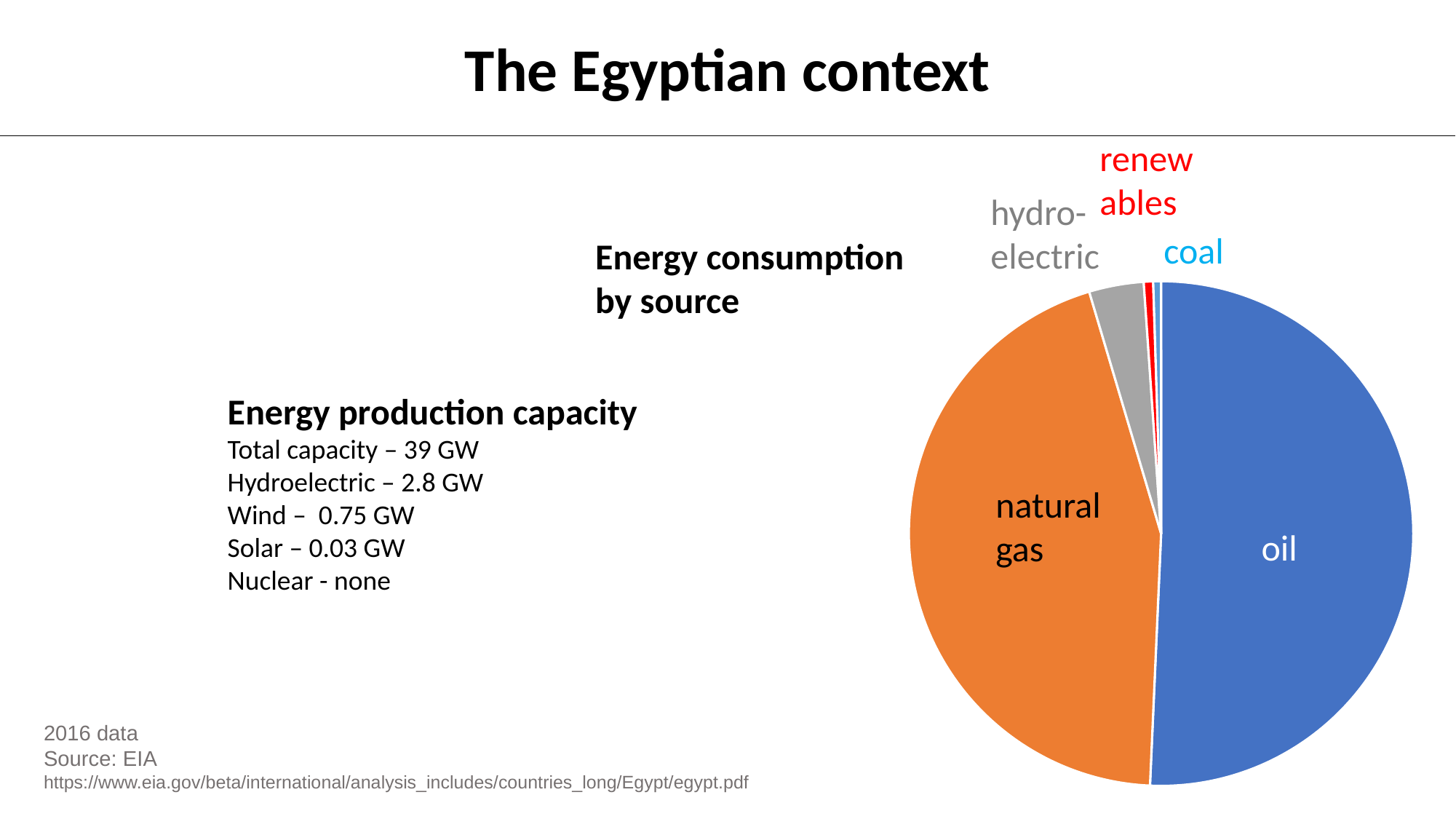
Which slice is larger in the pie chart, oil or natural gas? oil What is the title of the pie chart? Energy consumption by source Which slice is larger in the pie chart, natural gas or hydroelectric? natural gas Which energy source is shown in orange in the pie chart? natural gas What kind of chart is shown on the slide? pie chart Which energy source has the largest slice in the pie chart? oil Which slice is larger in the pie chart, hydroelectric or renewables? hydroelectric What colour is the oil slice in the pie chart? blue How many slices does the pie chart have? 5